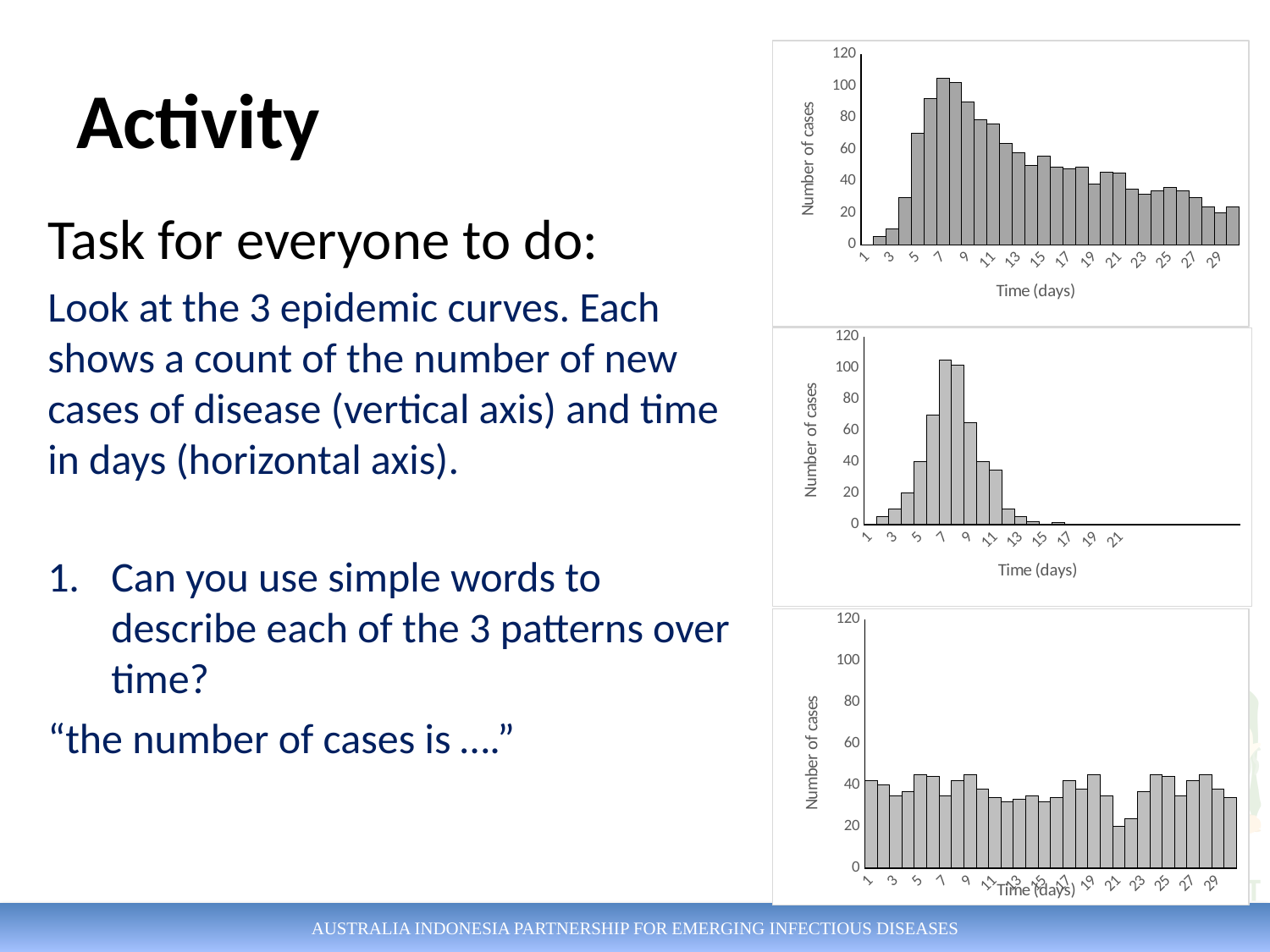
In the top chart, do the values rise or fall from day 9 to day 29? fall What kind of chart is the top chart on the slide? bar chart In the middle chart, which is larger, the value for day 9 or the value for day 13? day 9 In the middle chart, is the value for day 7 greater or less than 80? greater In the bottom chart, which day has the lowest number of cases? 21 In the top chart, is the value for day 7 greater or less than 80? greater How many charts are shown on the slide? 3 In the top chart, is the value for day 29 greater or less than 40? less What is the vertical axis title of the top chart? Number of cases In the top chart, which is larger, the value for day 5 or the value for day 15? day 5